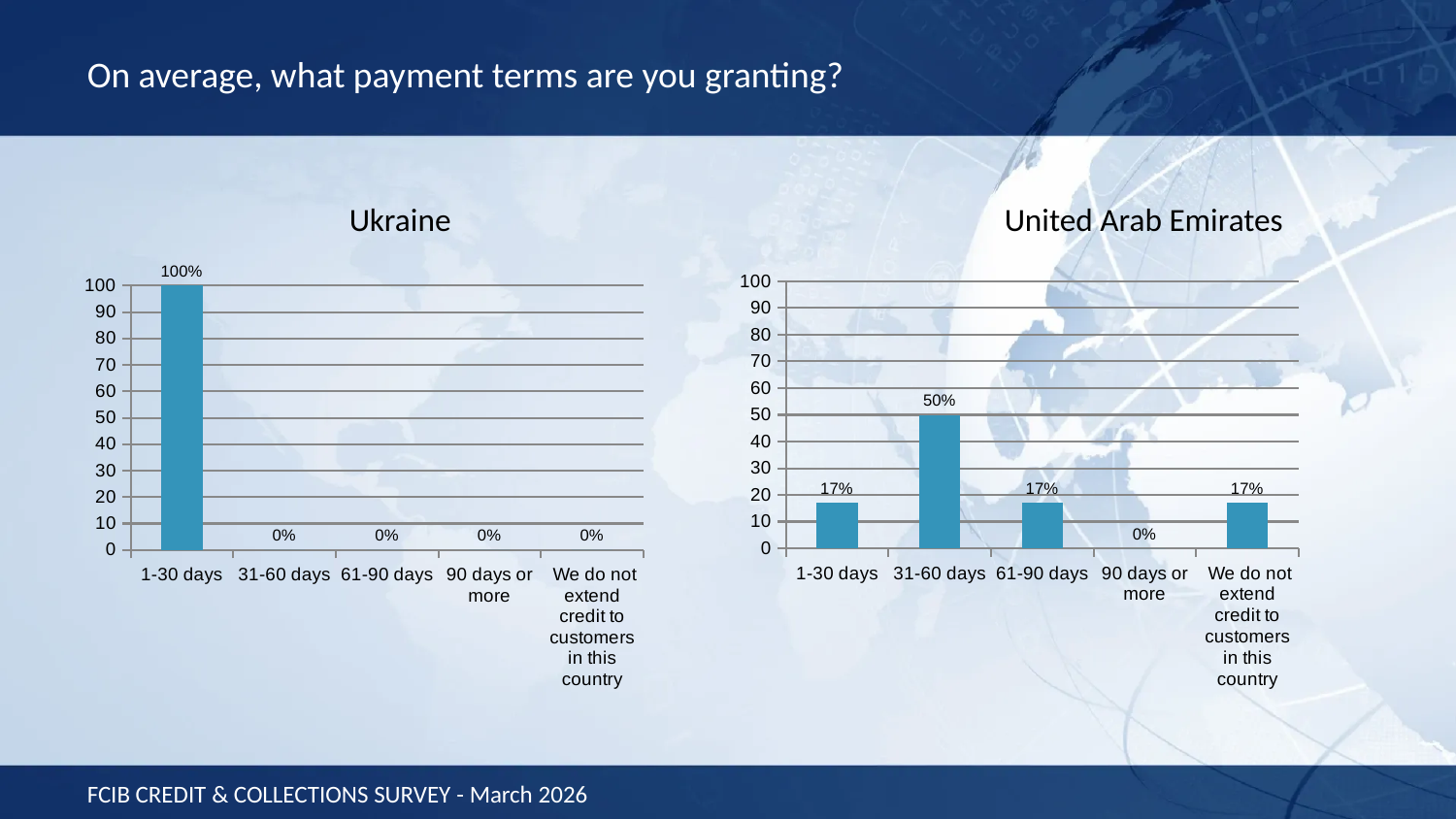
How many categories are shown in the Ukraine chart? 5 What is the title of the chart on the right side of the slide? United Arab Emirates In the United Arab Emirates chart, what is the value for 31-60 days? 50% What kind of chart is the United Arab Emirates chart? Bar chart In the United Arab Emirates chart, which category has the highest value? 31-60 days In the United Arab Emirates chart, what is the value for 90 days or more? 0% In the Ukraine chart, what is the value for 1-30 days? 100% In the United Arab Emirates chart, which is larger, the value for 31-60 days or the value for 61-90 days? 31-60 days In the Ukraine chart, which category has the highest value? 1-30 days In the United Arab Emirates chart, what is the difference between the values for 31-60 days and 1-30 days? 33% In the Ukraine chart, what is the value for 31-60 days? 0% In the United Arab Emirates chart, which category has the lowest value? 90 days or more